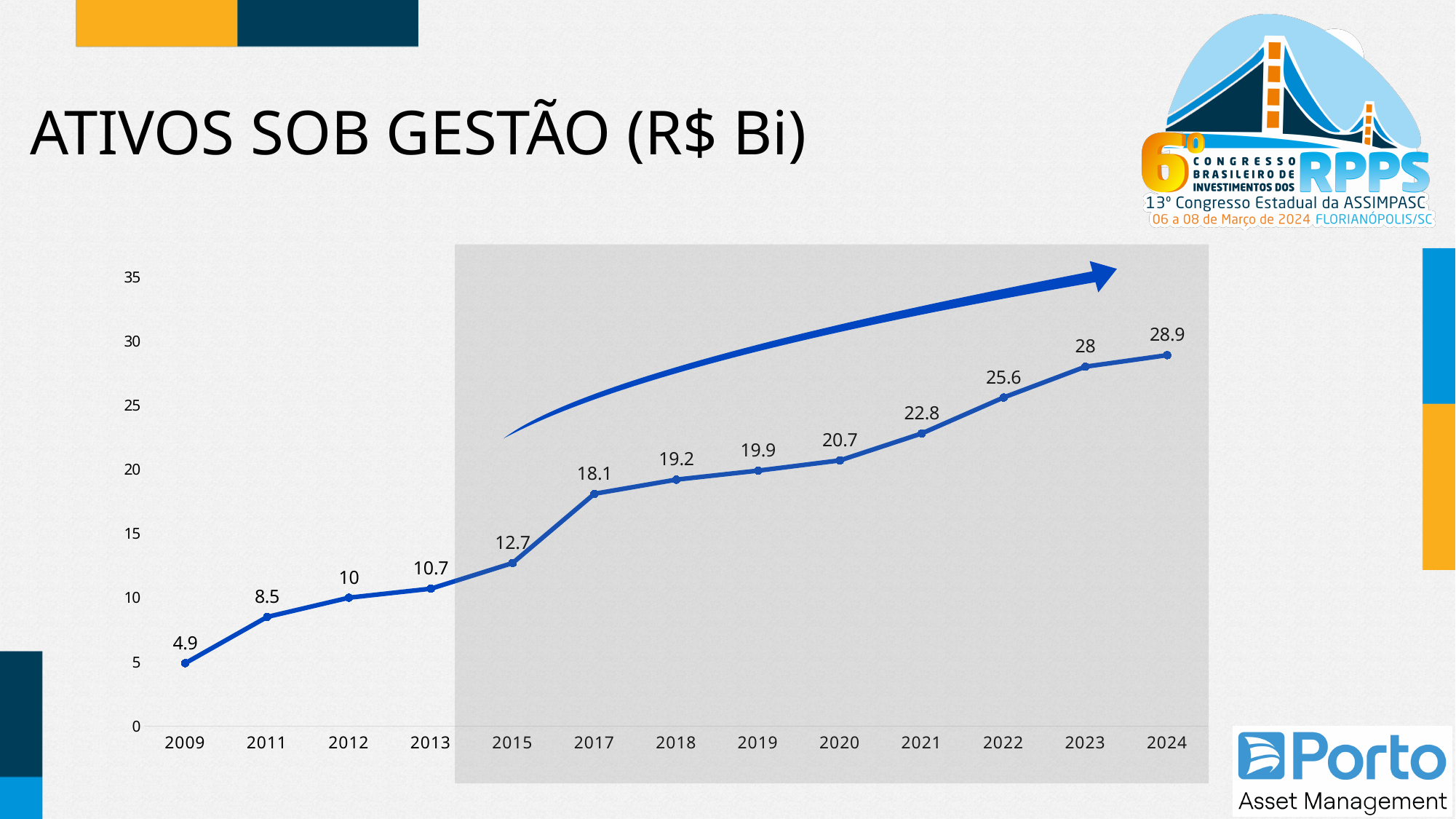
Which is larger, the value for 2013 or the value for 2018? 2018 What is the value for 2009? 4.9 Do the values rise or fall from 2009 to 2024? Rise How many years are plotted on the x axis? 13 What kind of chart is shown on the slide? Line chart What is the difference between the values for 2024 and 2009? 24 What is the value for 2024? 28.9 What is the difference between the values for 2017 and 2015? 5.4 Which year has the highest value? 2024 What is the value for 2017? 18.1 Which year has the lowest value? 2009 What is the value for 2021? 22.8